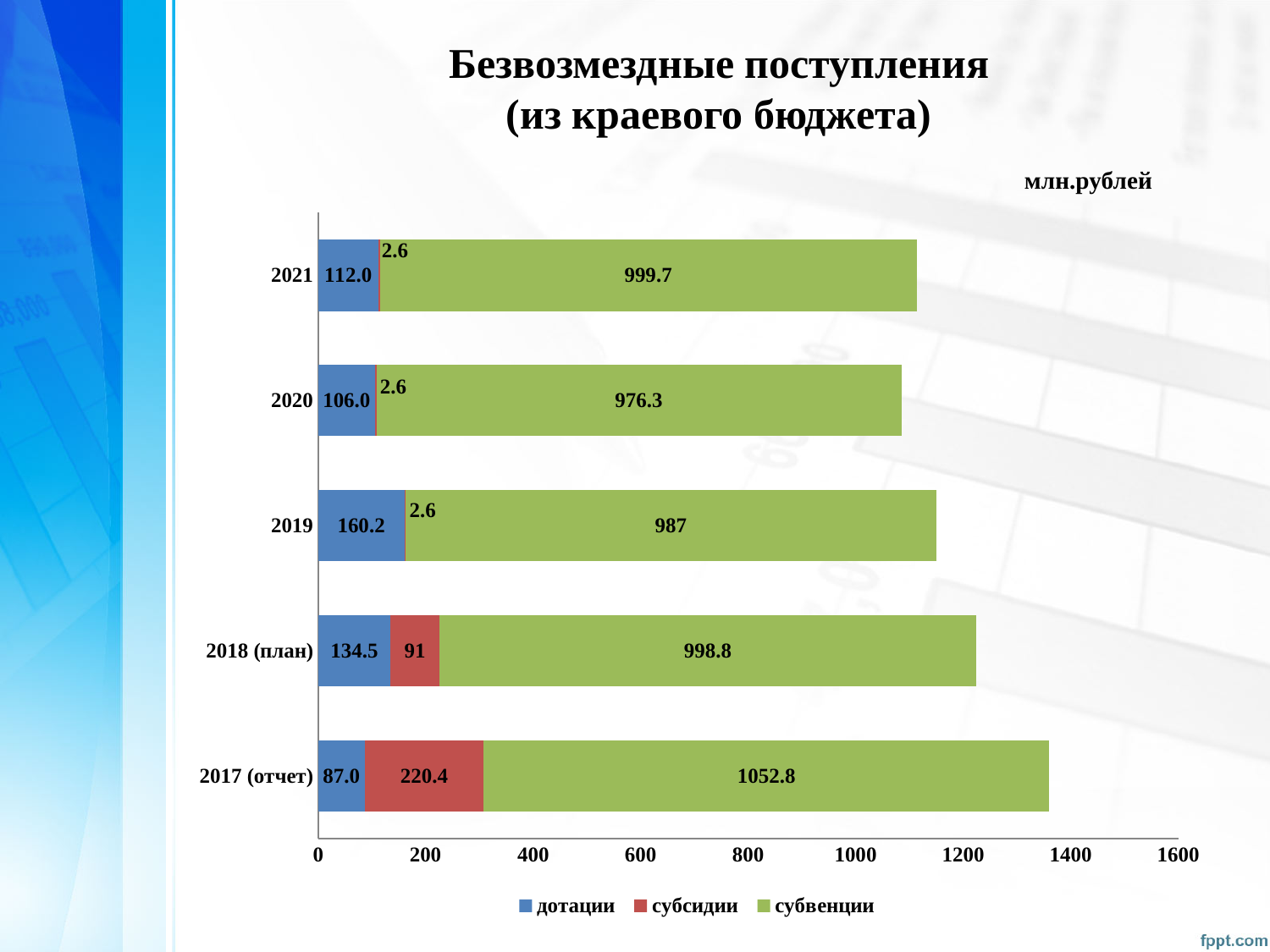
What is the value of дотации for 2019? 160.2 What is the difference between субвенции in 2021 and in 2020? 23.4 What type of chart is shown on the slide? stacked bar chart What is the total of the stacked bar for 2020? 1084.9 How many categories are shown on the chart? 5 Which category has the highest value of субсидии? 2017 (отчет) How many series does the legend list? 3 What is the total of the stacked bar for 2017 (отчет)? 1360.2 Which is larger: дотации in 2018 (план) or дотации in 2021? 2018 (план) Which category has the lowest value of дотации? 2017 (отчет) What is the value of субвенции for 2017 (отчет)? 1052.8 What is the value of субсидии for 2018 (план)? 91